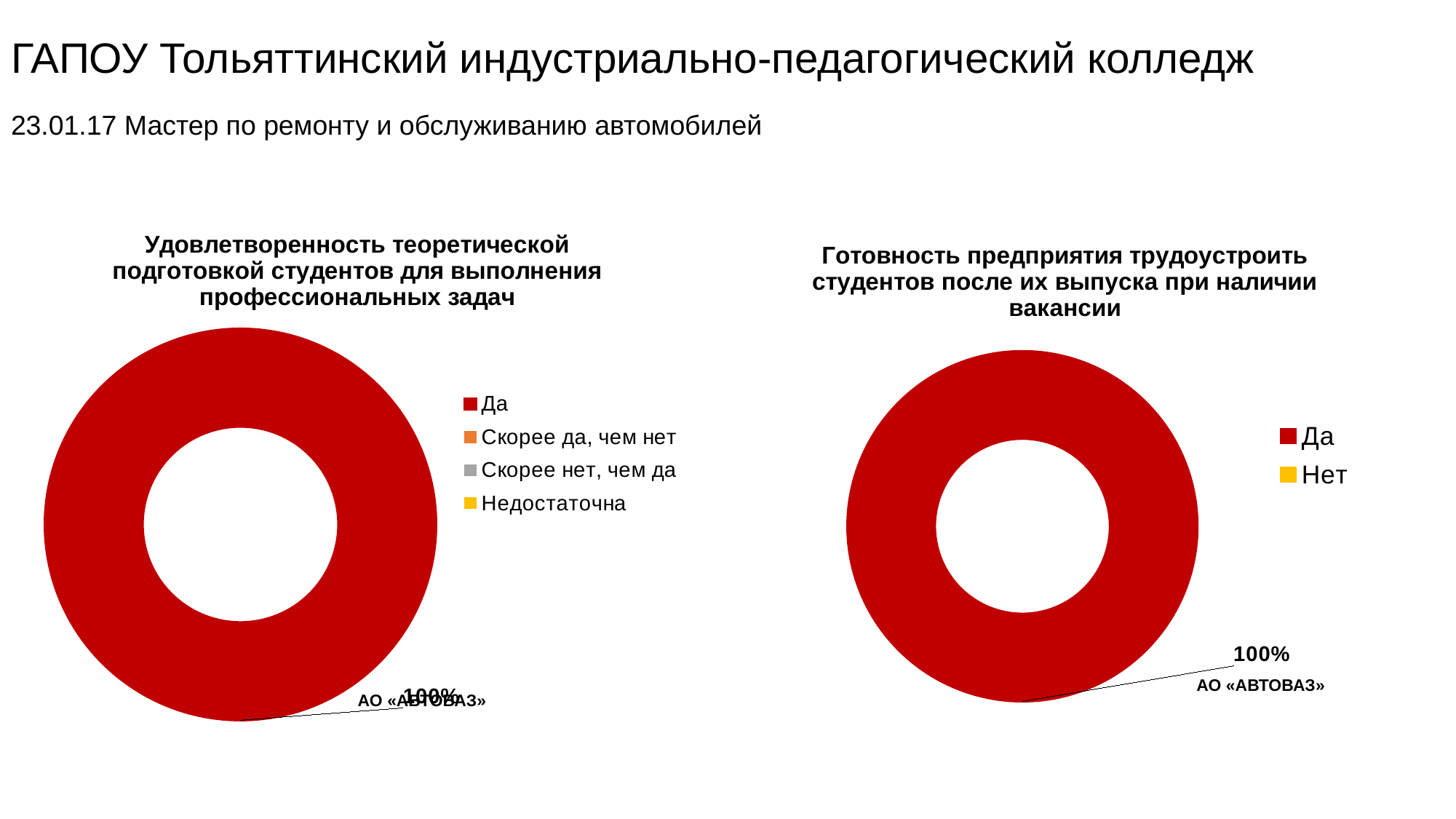
What kind of chart is the left chart, titled "Удовлетворенность теоретической подготовкой студентов для выполнения профессиональных задач"? Doughnut (pie) chart In the left chart ("Удовлетворенность теоретической подготовкой..."), how many entries does the legend list? 4 What kind of chart is the right chart, titled "Готовность предприятия трудоустроить студентов после их выпуска при наличии вакансии"? Doughnut (pie) chart In the right chart ("Готовность предприятия трудоустроить..."), which category fills the entire doughnut? Да In the right chart ("Готовность предприятия трудоустроить..."), what share of the doughnut does the "Да" category take? 100% In the left chart ("Удовлетворенность теоретической подготовкой..."), what share of the doughnut does the "Да" category take? 100% In the right chart ("Готовность предприятия трудоустроить..."), which enterprise is named in the label next to the doughnut? АО «АВТОВАЗ» In the left chart ("Удовлетворенность теоретической подготовкой..."), which category fills the entire doughnut? Да In the right chart ("Готовность предприятия трудоустроить..."), what is the data label printed next to the doughnut? 100% In the right chart ("Готовность предприятия трудоустроить..."), which legend entry is shown in yellow? Нет In the left chart ("Удовлетворенность теоретической подготовкой..."), which legend entry is listed last? Недостаточна In the right chart ("Готовность предприятия трудоустроить..."), how many entries does the legend list? 2